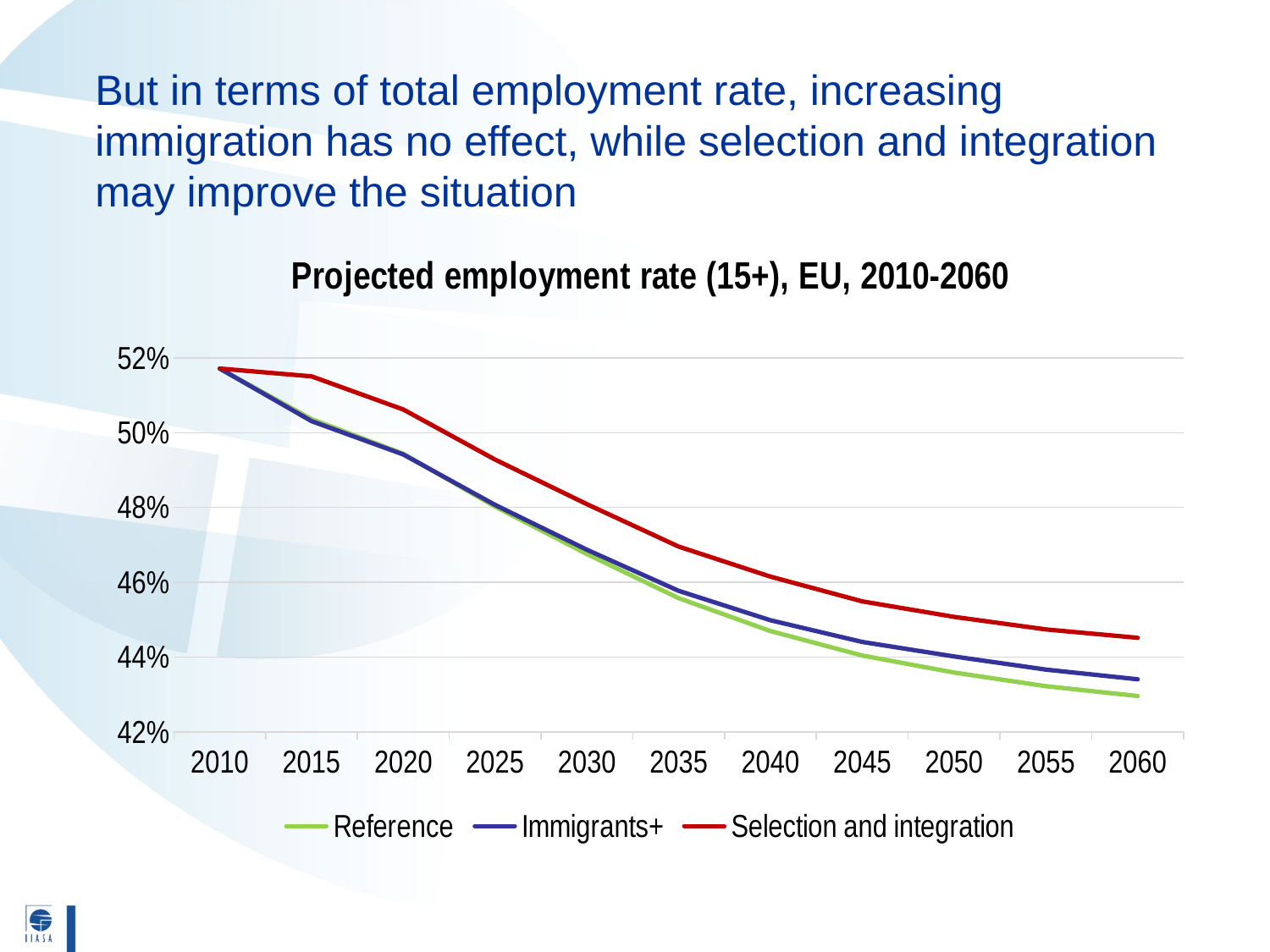
Which series has the highest value in 2060? Selection and integration What kind of chart is shown on the slide? line chart How many series does the legend list? 3 Which series has the lowest value in 2060? Reference What is the title of the chart? Projected employment rate (15+), EU, 2010-2060 Which series is drawn in red? Selection and integration How many years are marked along the x axis? 11 Is the value for Reference in 2060 greater or less than 44%? less In 2040, which is larger: the value for Selection and integration or the value for Immigrants+? Selection and integration Do the values for the Reference series rise or fall from 2010 to 2060? fall Is the value for Selection and integration in 2020 greater or less than 50%? greater Is the value for Selection and integration in 2060 greater or less than 44%? greater